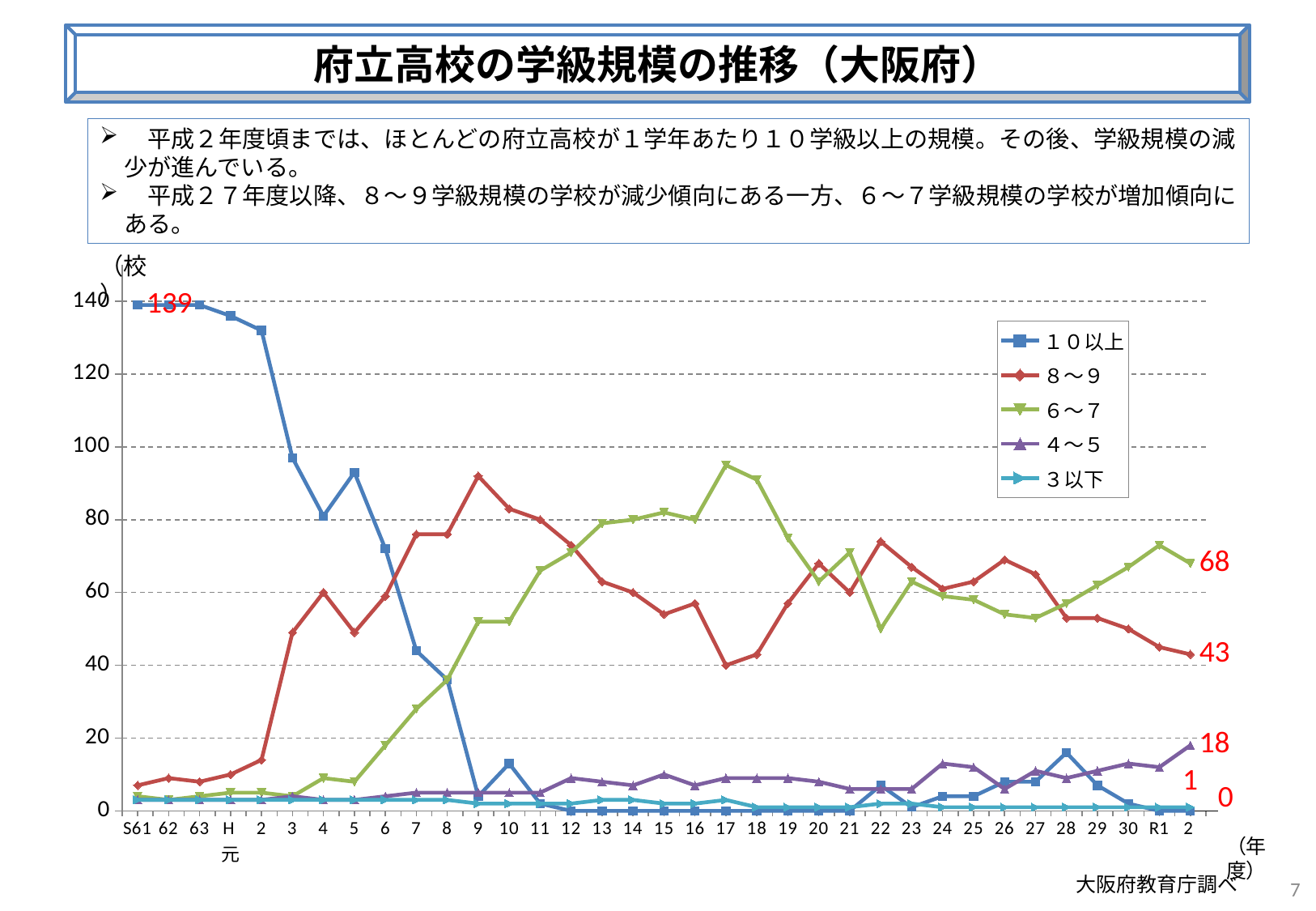
What is the value of the 8～9 series at the final year (R2)? 43 Which series has the highest value at the final year (R2)? 6～7 At the final year (R2), what is the difference between the 6～7 series and the 8～9 series? 25 At the final year (R2), which is larger: the 6～7 series or the 8～9 series? 6～7 What is the value of the 4～5 series at the final year (R2)? 18 Is the value of the 6～7 series at H17 greater or less than 80? greater How many series does the legend list? 5 What is the value of the 6～7 series at the final year (R2)? 68 What kind of chart is shown on the slide? line chart Is the value of the 10以上 series at H5 greater or less than 80? greater Does the 10以上 series rise or fall from S61 to H12? fall What is the value of the 10以上 series at S61? 139